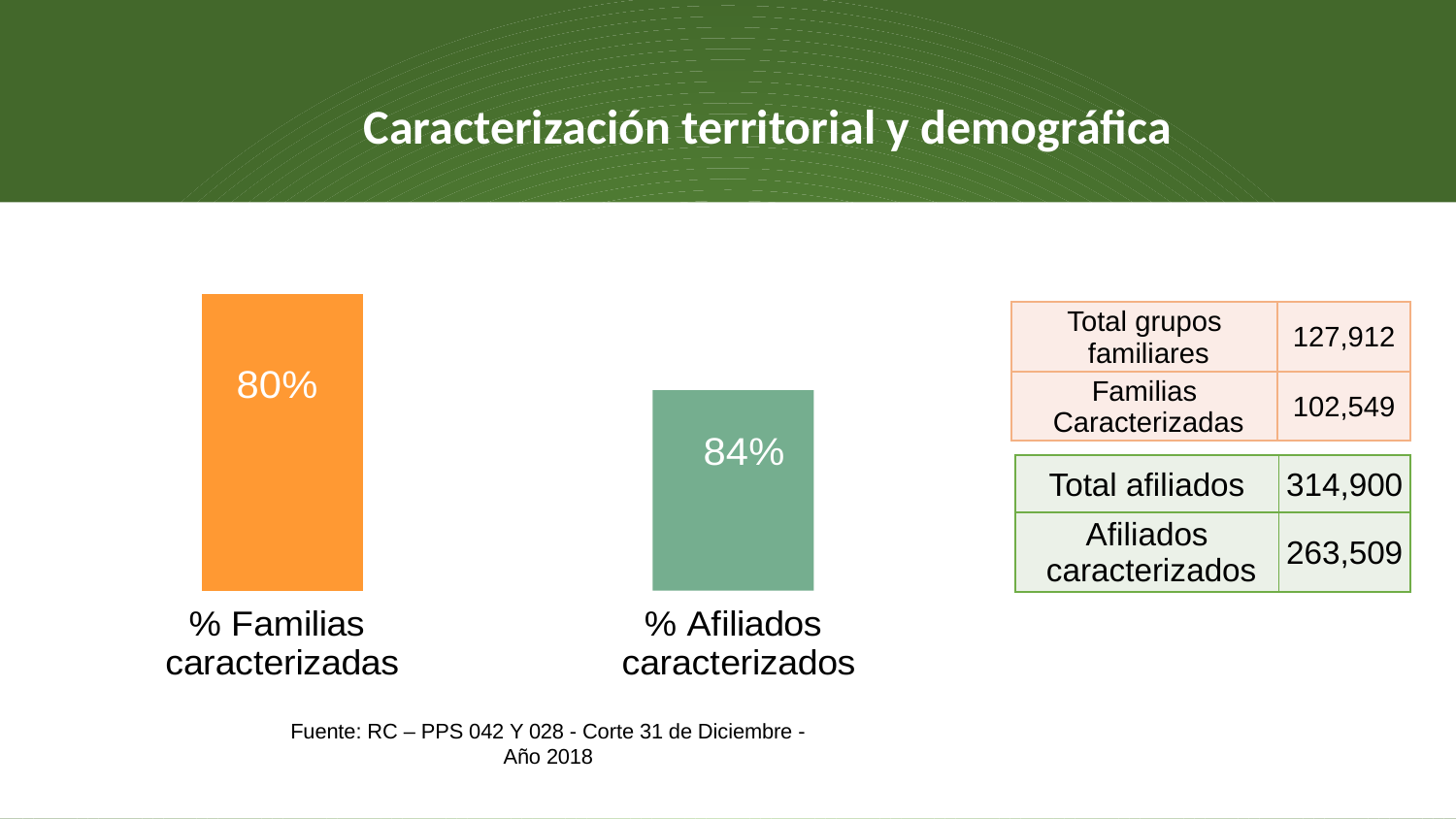
Which has the larger printed percentage, % Familias caracterizadas or % Afiliados caracterizados? % Afiliados caracterizados What colour is the bar for % Afiliados caracterizados? Green What is the value shown for % Familias caracterizadas? 80% Is the value for % Afiliados caracterizados greater or less than 90%? less How many bars are plotted in the chart? 2 What kind of chart is shown on the slide? Bar chart Is the value for % Familias caracterizadas greater or less than 50%? greater What is the value shown for % Afiliados caracterizados? 84% What is the difference between the % Afiliados caracterizados value and the % Familias caracterizadas value? 4% What colour is the bar for % Familias caracterizadas? Orange